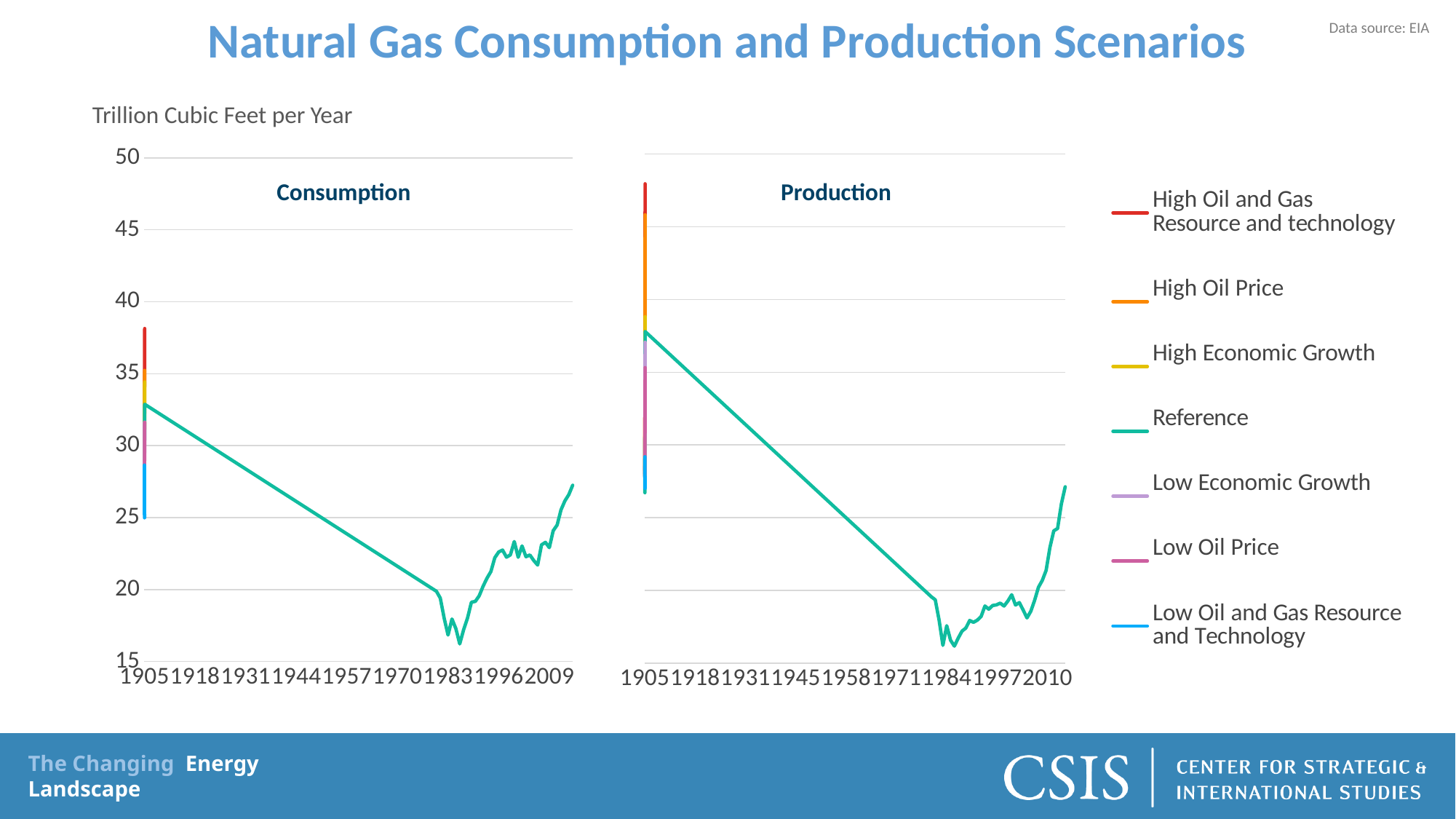
What kind of chart is the Consumption chart? line chart In the Consumption chart, is the Reference value at the right end of the line (2009) greater or less than 25? greater In the Consumption chart, is the lowest point of the Reference line greater or less than 20? less How many series does the legend list? 7 In the Production chart, is the lowest point of the Reference line greater or less than 20? less What unit is shown on the y axis of the charts? Trillion Cubic Feet per Year What is the title of the slide's chart? Natural Gas Consumption and Production Scenarios What is the highest value shown on the y axis of the charts? 50 Which chart reaches a higher peak value, Consumption or Production? Production